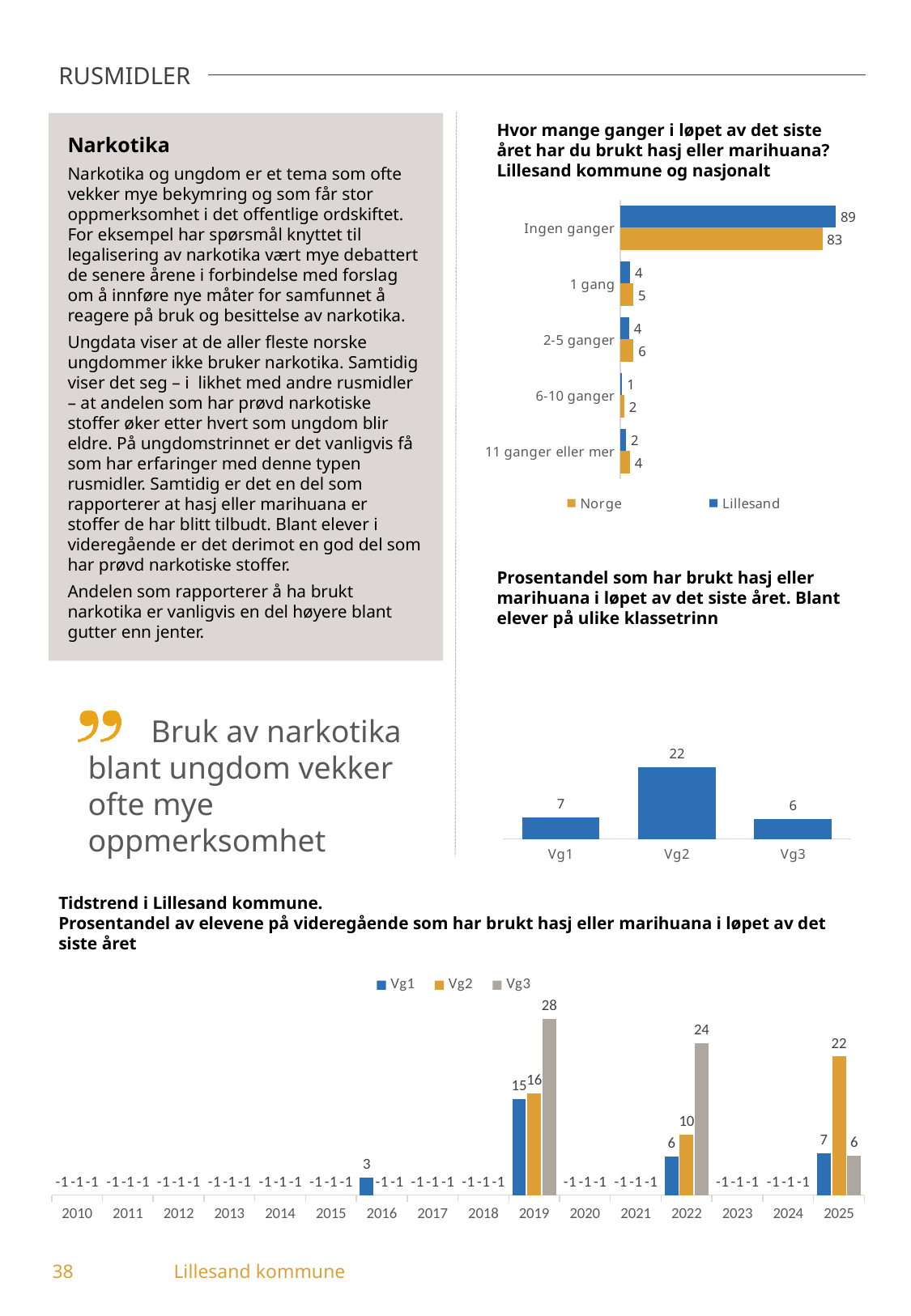
In the chart 'Hvor mange ganger i løpet av det siste året har du brukt hasj eller marihuana?', how many categories are shown? 5 In the chart 'Hvor mange ganger i løpet av det siste året har du brukt hasj eller marihuana?', how many series does the legend list? 2 In the chart 'Hvor mange ganger i løpet av det siste året har du brukt hasj eller marihuana?', what is the difference between the Lillesand and Norge values for 'Ingen ganger'? 6 In the chart 'Tidstrend i Lillesand kommune', how many series does the legend list? 3 In the chart 'Tidstrend i Lillesand kommune', what is the difference between Vg2 and Vg1 in 2025? 15 In the chart 'Prosentandel som har brukt hasj eller marihuana i løpet av det siste året. Blant elever på ulike klassetrinn', what kind of chart is it? Bar chart In the chart 'Hvor mange ganger i løpet av det siste året har du brukt hasj eller marihuana?', what is the value for Norge in the category '2-5 ganger'? 6 In the chart 'Tidstrend i Lillesand kommune', what is the value for Vg3 in 2019? 28 In the chart 'Prosentandel som har brukt hasj eller marihuana i løpet av det siste året. Blant elever på ulike klassetrinn', what is the value for Vg1? 7 In the chart 'Prosentandel som har brukt hasj eller marihuana i løpet av det siste året. Blant elever på ulike klassetrinn', which class level has the highest value? Vg2 In the chart 'Tidstrend i Lillesand kommune', which is larger in 2022: Vg2 or Vg3? Vg3 In the chart 'Hvor mange ganger i løpet av det siste året har du brukt hasj eller marihuana?', what is the value for Lillesand in the category 'Ingen ganger'? 89